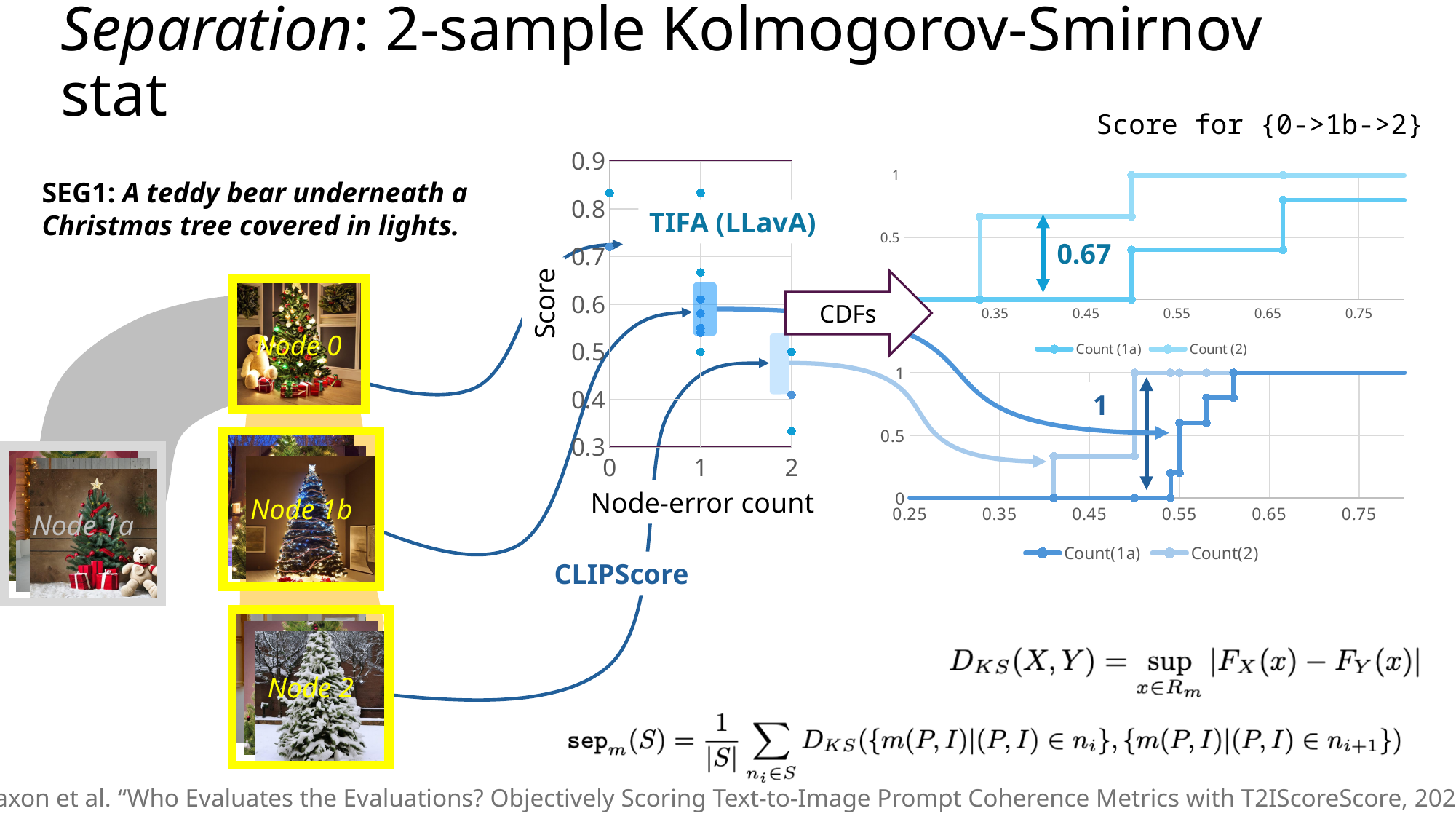
What title is printed above the CDF charts on the right of the slide? Score for {0->1b->2} What are the two legend entries of the bottom CDF chart? Count(1a) and Count(2) In the scatter chart of Score vs Node-error count, do the scores rise or fall as the node-error count increases? fall How many series does the legend of the top CDF chart (Count (1a), Count (2)) list? 2 In the scatter chart of Score vs Node-error count, is the lowest score at node-error count 2 greater or less than 0.4? less What is the KS distance value annotated between the two curves in the top CDF chart? 0.67 In the scatter chart of Score vs Node-error count, how many node-error count values are shown on the x axis? 3 In the scatter chart of Score vs Node-error count, is the highest score at node-error count 0 greater or less than 0.8? greater What kind of chart is the middle chart with axes 'Score' and 'Node-error count'? scatter plot What is the KS distance value annotated between the two curves in the bottom CDF chart? 1 In the scatter chart of Score vs Node-error count, is the highest score at node-error count 2 greater or less than 0.6? less Which CDF chart shows the larger annotated KS distance, the top one or the bottom one? the bottom one